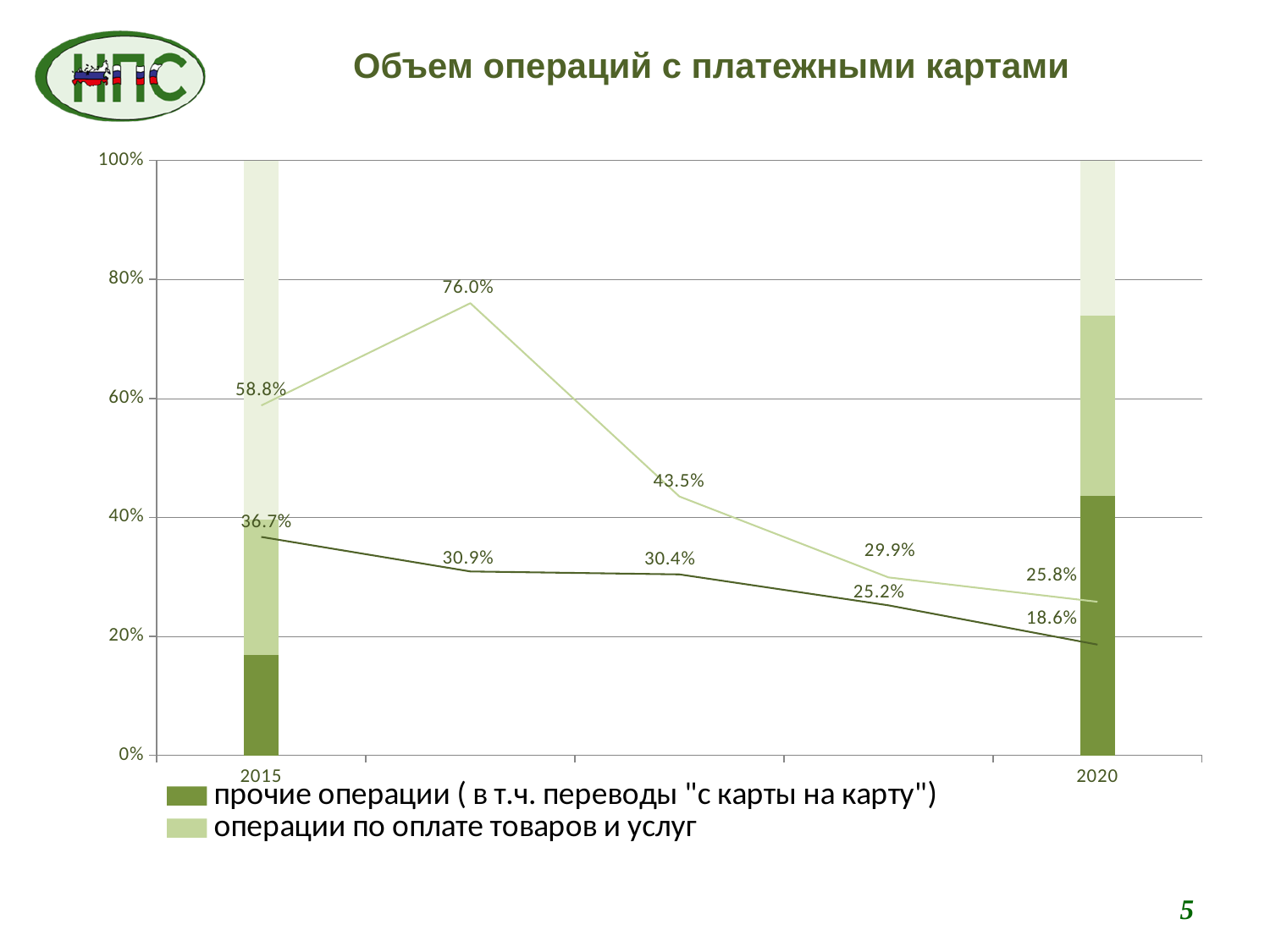
What is the difference between the upper line (58.8%) and the lower line (36.7%) at 2015? 22.1 percentage points What is the title of the chart? Объем операций с платежными картами What kind of chart is shown on the slide? A combined bar and line chart How many series does the legend list? 2 What is the highest value labeled on the upper line? 76.0% What is the value of the upper line at 2015? 58.8% What is the value of the lower line at 2020? 18.6% Does the lower line rise or fall from 2015 to 2020? Fall What is the lowest value labeled on the lower line? 18.6% How many labeled data points does the upper line have? 5 Is the dark green bar segment for 2015 greater or less than 20%? less In which year is the dark green bar segment (прочие операции) larger, 2015 or 2020? 2020